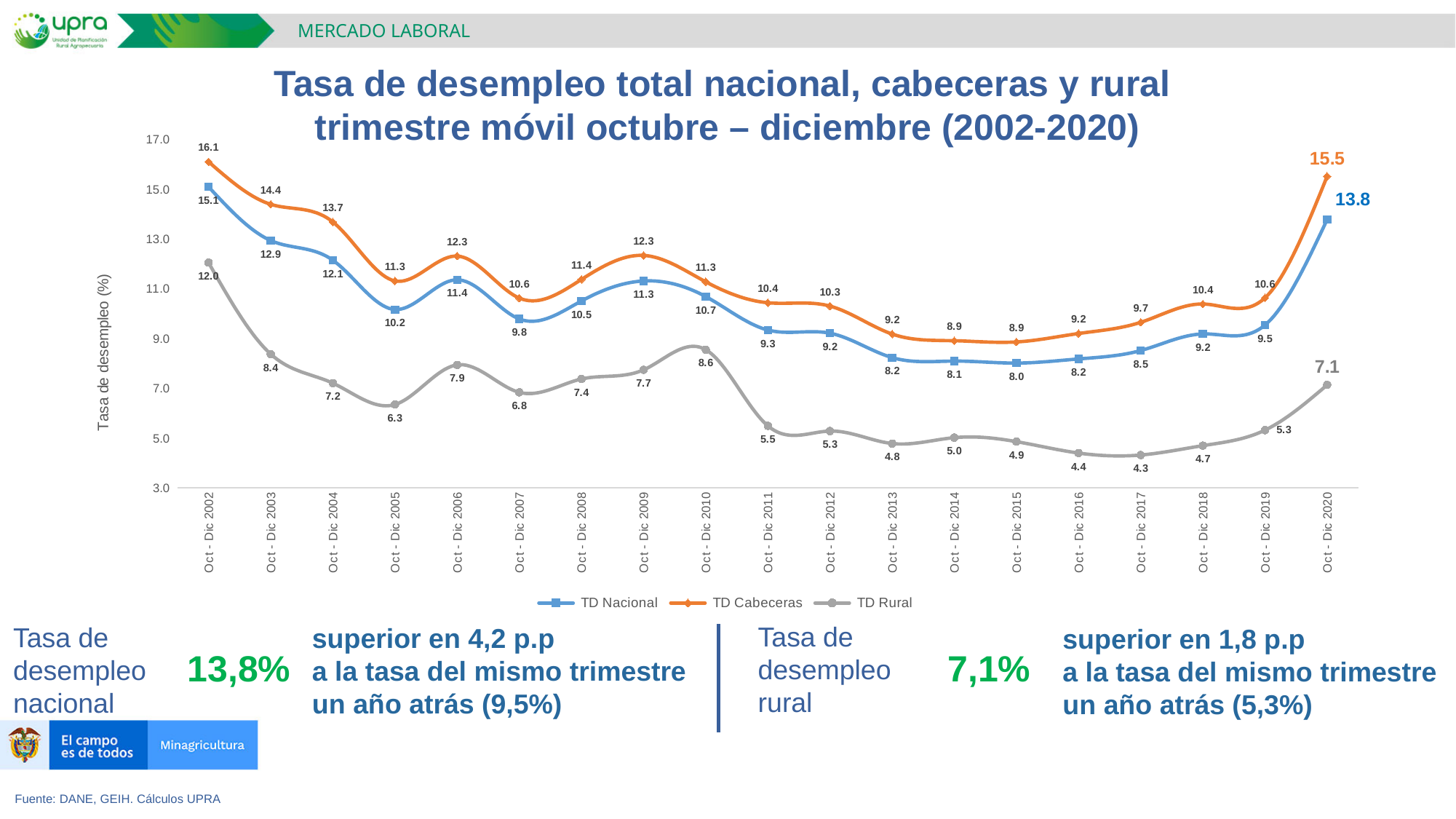
Which period has the higher TD Rural value, Oct - Dic 2009 or Oct - Dic 2010? Oct - Dic 2010 In which period does TD Cabeceras reach its highest value? Oct - Dic 2002 How many series does the legend list? 3 In which period does TD Rural reach its lowest value? Oct - Dic 2017 Which series is drawn in orange? TD Cabeceras What kind of chart is shown on the slide? Line chart What is the value of TD Rural for Oct - Dic 2005? 6.3 What is the value of TD Cabeceras for Oct - Dic 2020? 15.5 What is the value of TD Nacional for Oct - Dic 2015? 8.0 By how much did TD Nacional increase from Oct - Dic 2019 to Oct - Dic 2020? 4.3 How many periods are plotted on the x axis? 19 Does TD Nacional rise or fall from Oct - Dic 2002 to Oct - Dic 2005? Fall